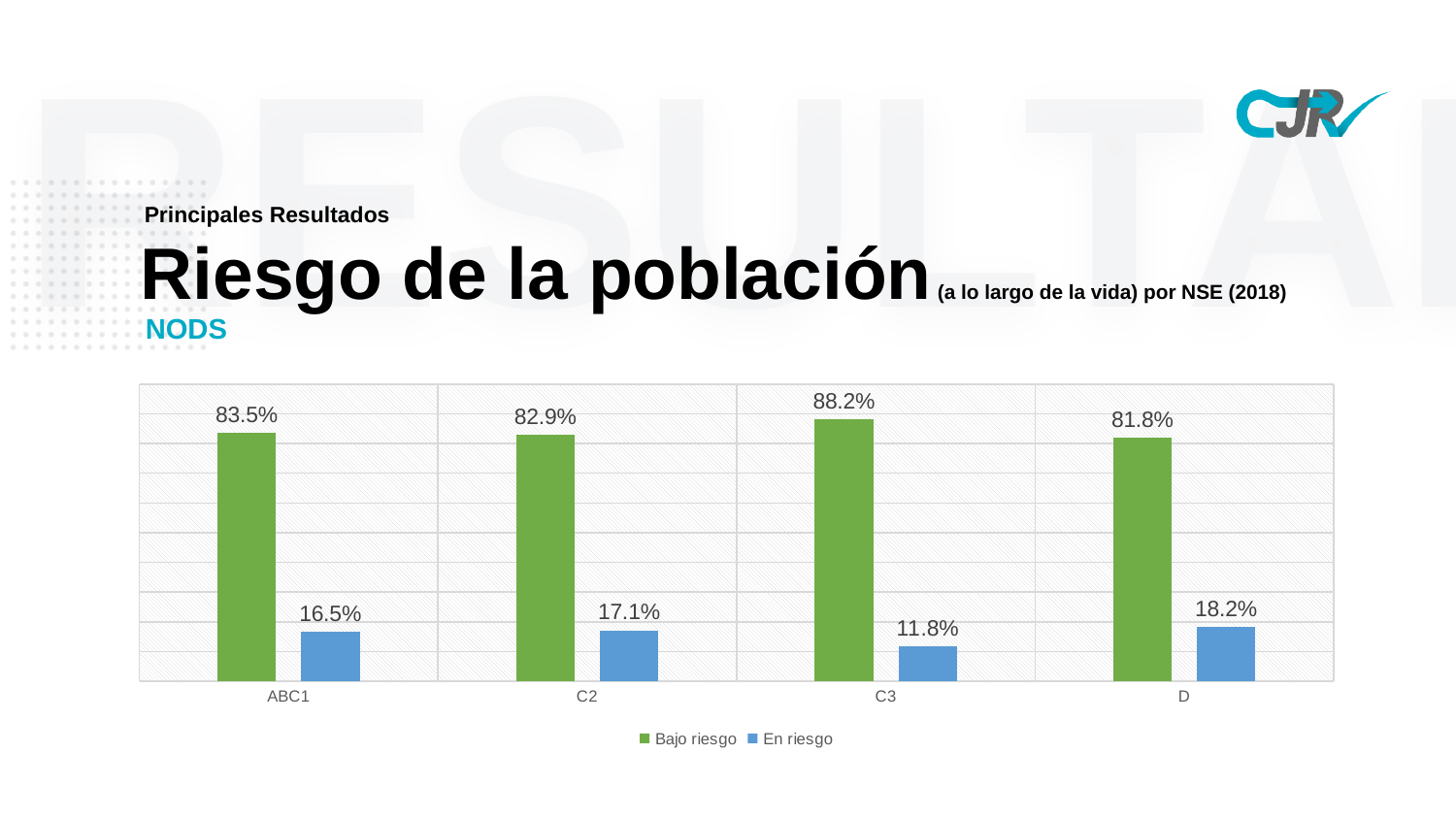
Which category has the lowest En riesgo value? C3 What is the value of Bajo riesgo for ABC1? 83.5% How many series does the legend list? 2 What kind of chart is shown on the slide? Bar chart Which colour represents the En riesgo series in the legend? Blue How many categories are shown on the x axis? 4 Which category has the highest Bajo riesgo value? C3 Which is larger, the En riesgo value for ABC1 or for D? D What is the difference between the Bajo riesgo and En riesgo values for C2? 65.8% What is the value of En riesgo for C3? 11.8% What is the difference between the Bajo riesgo values for C3 and D? 6.4% What is the value of En riesgo for D? 18.2%